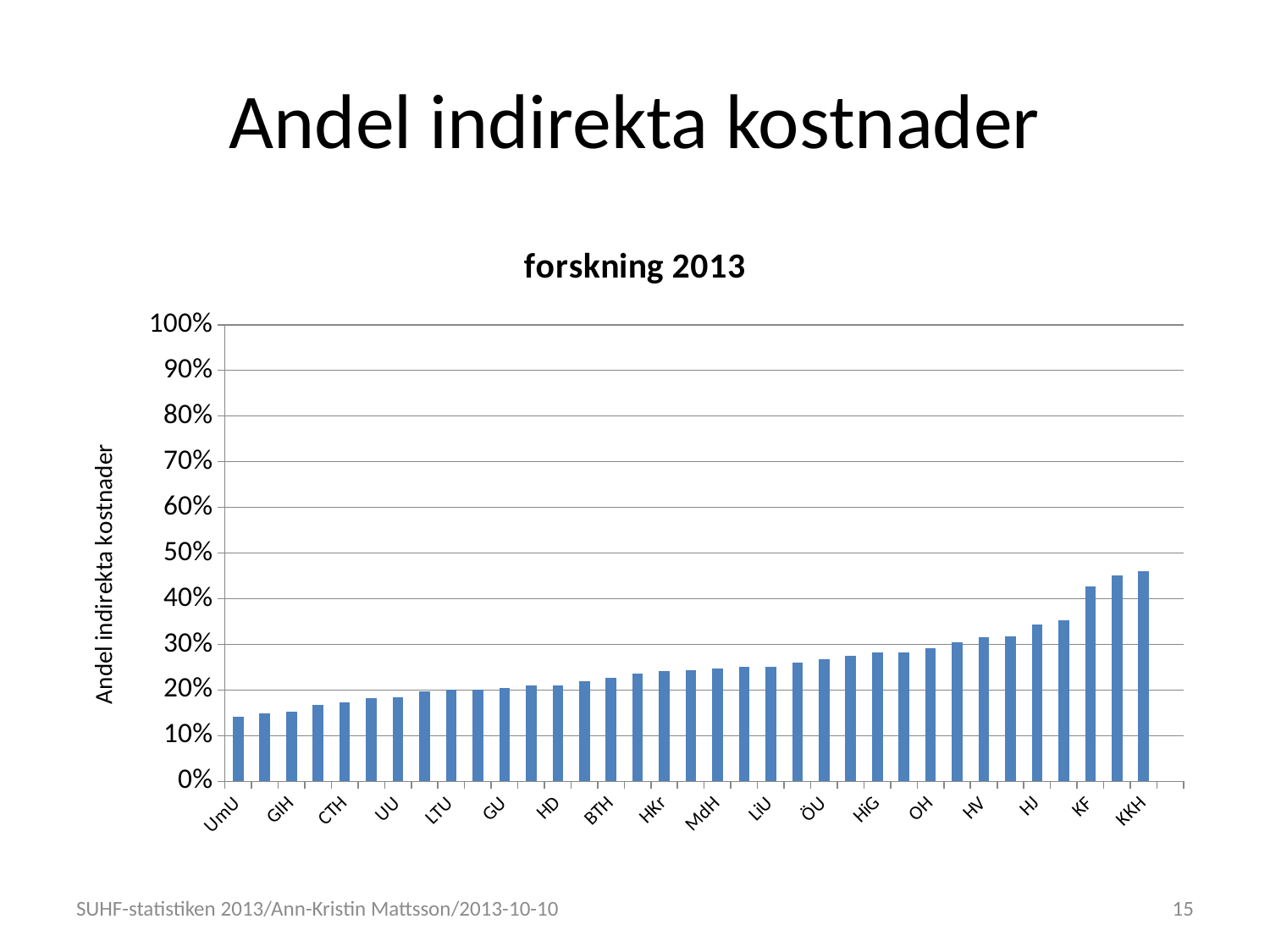
Which is larger, the value for KF or the value for HJ? KF Which is larger, the value for GIH or the value for LiU? LiU Do the values rise or fall from left to right along the x axis? rise What is the title of the chart? forskning 2013 What kind of chart is shown on the slide? bar chart Which category has the lowest value? UmU What is the label of the vertical axis? Andel indirekta kostnader Which category has the highest value? KKH Is the value for LiU greater or less than 30%? less Is the value for KF greater or less than 40%? greater Is the value for UmU greater or less than 20%? less